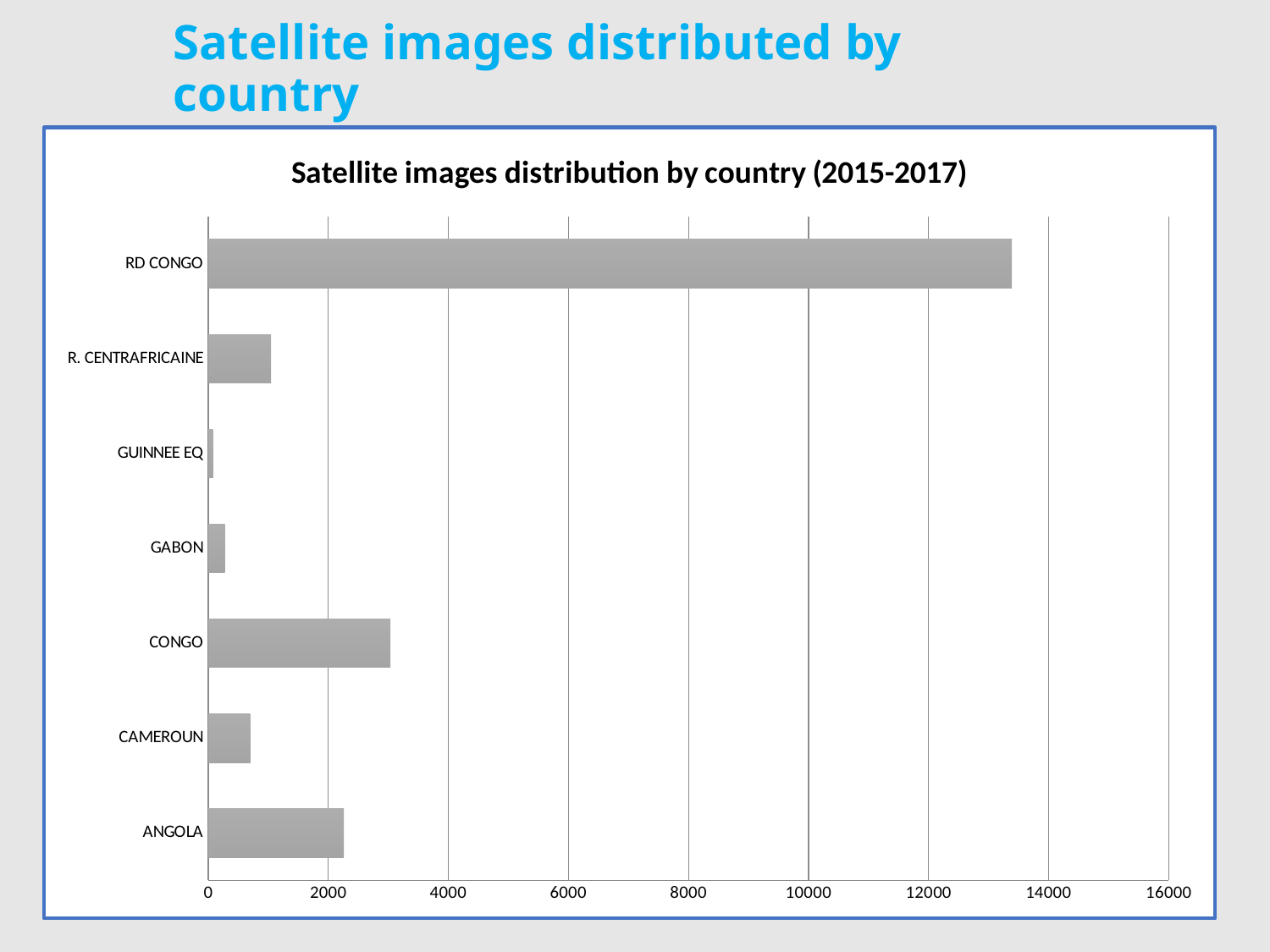
Which has a higher value, CONGO or ANGOLA? CONGO What is the title of the chart? Satellite images distribution by country (2015-2017) Which country received the fewest satellite images? GUINNEE EQ Which has a higher value, GABON or GUINNEE EQ? GABON Which country received the most satellite images? RD CONGO How many countries are shown in the chart? 7 Is the value for RD CONGO greater or less than 12000? greater Is the value for CONGO greater or less than 2000? greater What kind of chart is shown on the slide? bar chart Is the value for CAMEROUN greater or less than 2000? less Which has a higher value, R. CENTRAFRICAINE or CAMEROUN? R. CENTRAFRICAINE